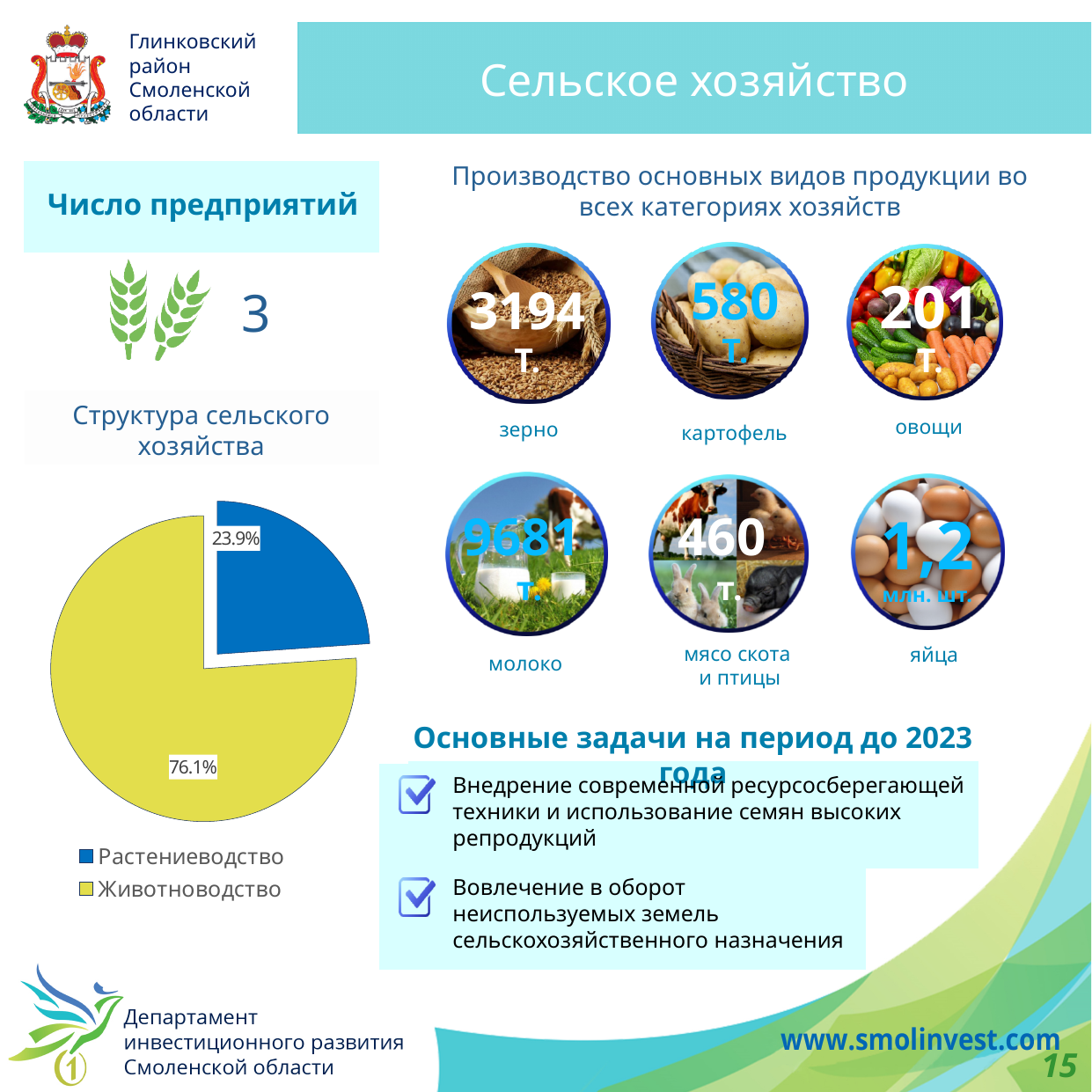
In the pie chart "Структура сельского хозяйства", what colour is the Растениеводство slice? blue In the pie chart "Структура сельского хозяйства", by how many percentage points does Животноводство exceed Растениеводство? 52.2 percentage points What share of the pie chart "Структура сельского хозяйства" does the Животноводство slice represent? 76.1% What kind of chart is shown under the heading "Структура сельского хозяйства"? pie chart In the pie chart "Структура сельского хозяйства", which is larger: Растениеводство or Животноводство? Животноводство In the pie chart "Структура сельского хозяйства", what share is shown for Растениеводство? 23.9% Which slice of the pie chart "Структура сельского хозяйства" is the largest? Животноводство In the pie chart "Структура сельского хозяйства", what share is shown for Животноводство? 76.1% In the pie chart "Структура сельского хозяйства", what colour is the Животноводство slice? yellow How many slices does the pie chart "Структура сельского хозяйства" have? 2 Which slice of the pie chart "Структура сельского хозяйства" is the smallest? Растениеводство How many entries does the legend of the pie chart "Структура сельского хозяйства" list? 2